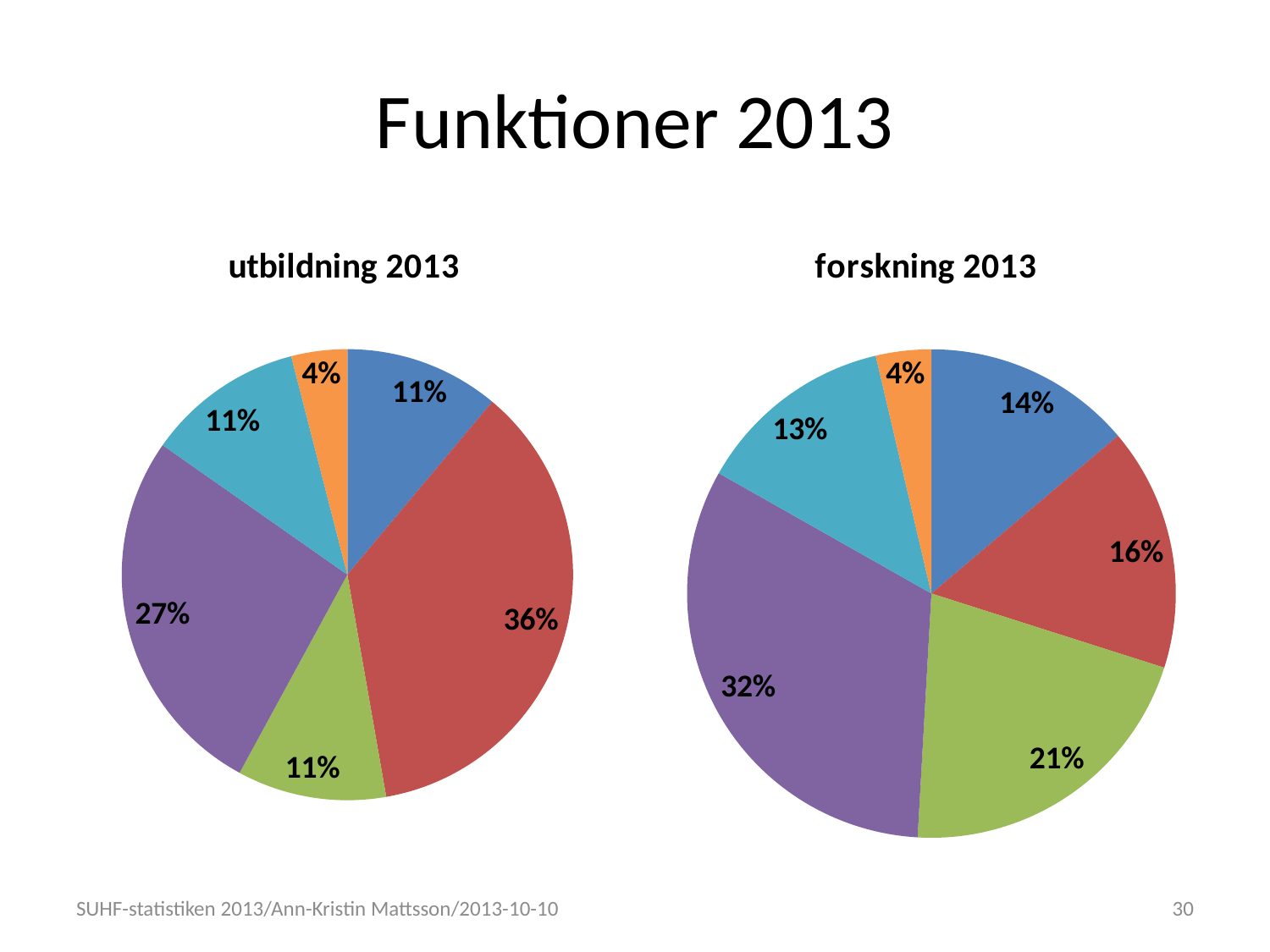
How many slices does the "forskning 2013" pie chart have? 6 In the "forskning 2013" chart, what is the difference between the green slice and the red slice? 5% In the "utbildning 2013" chart, what share does the largest slice (red) have? 36% What is the difference between the red slice and the purple slice in the "utbildning 2013" chart? 9% In the "forskning 2013" chart, what is the share of the teal (light blue) slice? 13% What is the title of the slide containing the two pie charts? Funktioner 2013 Which chart has the larger purple slice, "utbildning 2013" or "forskning 2013"? forskning 2013 In the "utbildning 2013" chart, what is the share of the purple slice? 27% In the "utbildning 2013" chart, what is the share of the smallest slice (orange)? 4% In the "forskning 2013" chart, what is the share of the green slice? 21% In the "forskning 2013" chart, what share does the largest slice (purple) have? 32% What kind of chart is the "utbildning 2013" chart? pie chart